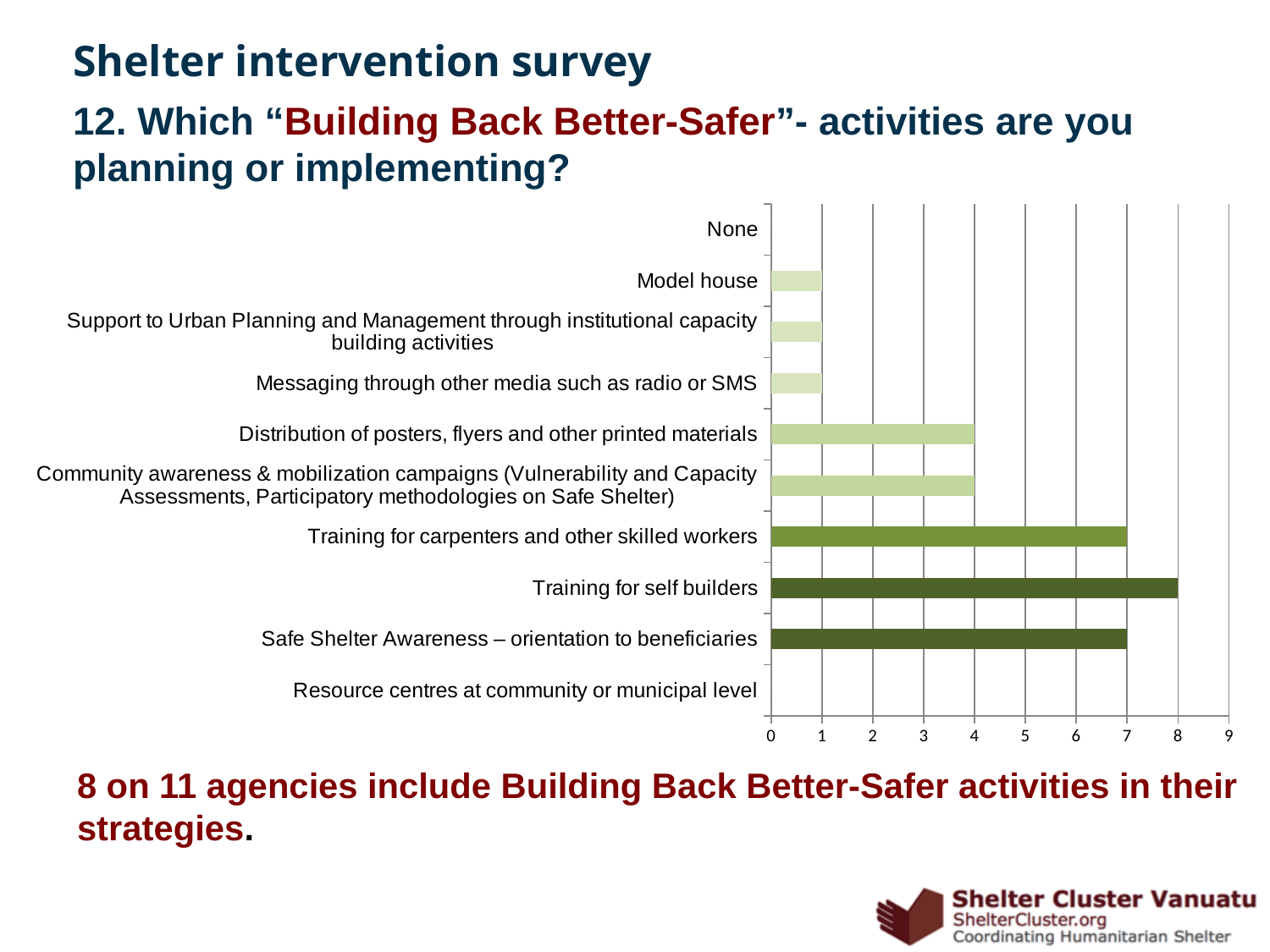
What is the highest value shown on the chart's horizontal axis? 9 What is the value for Distribution of posters, flyers and other printed materials? 4 Which activity has the highest value on the chart? Training for self builders Is the value for Community awareness & mobilization campaigns greater or less than 6? less What is the value for Model house? 1 What kind of chart is shown on the slide? bar chart What is the value for Training for self builders? 8 Which two categories on the chart have no bar at all? None; Resource centres at community or municipal level Which is larger: the value for Training for carpenters and other skilled workers or the value for Messaging through other media such as radio or SMS? Training for carpenters and other skilled workers What is the difference between the values for Training for self builders and Safe Shelter Awareness – orientation to beneficiaries? 1 What is the value for Training for carpenters and other skilled workers? 7 How many categories are listed on the chart's vertical axis? 10